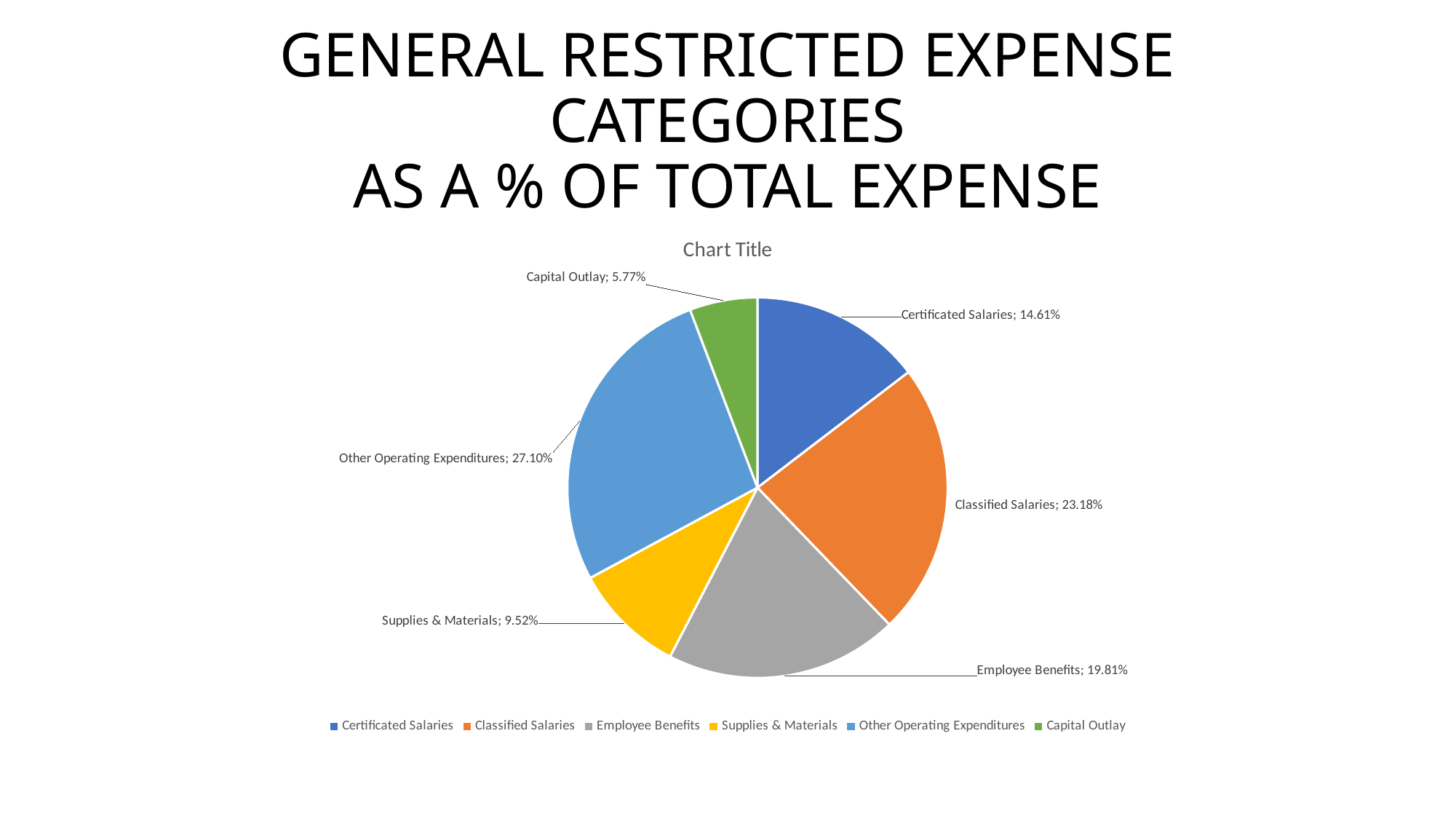
Which is larger, Employee Benefits or Supplies & Materials? Employee Benefits How many categories are shown in the pie chart? 6 What is the combined share of Certificated Salaries and Classified Salaries? 37.79% What is the value for Employee Benefits? 19.81% What colour is the Supplies & Materials slice? Yellow Which category has the smallest share of the pie? Capital Outlay What is the difference in percentage points between Classified Salaries and Certificated Salaries? 8.57 Which category has the largest share of the pie? Other Operating Expenditures What percentage is shown for Capital Outlay? 5.77% What type of chart is shown on the slide? Pie chart What is the value shown for Other Operating Expenditures? 27.10% What percentage of total expense is Classified Salaries? 23.18%